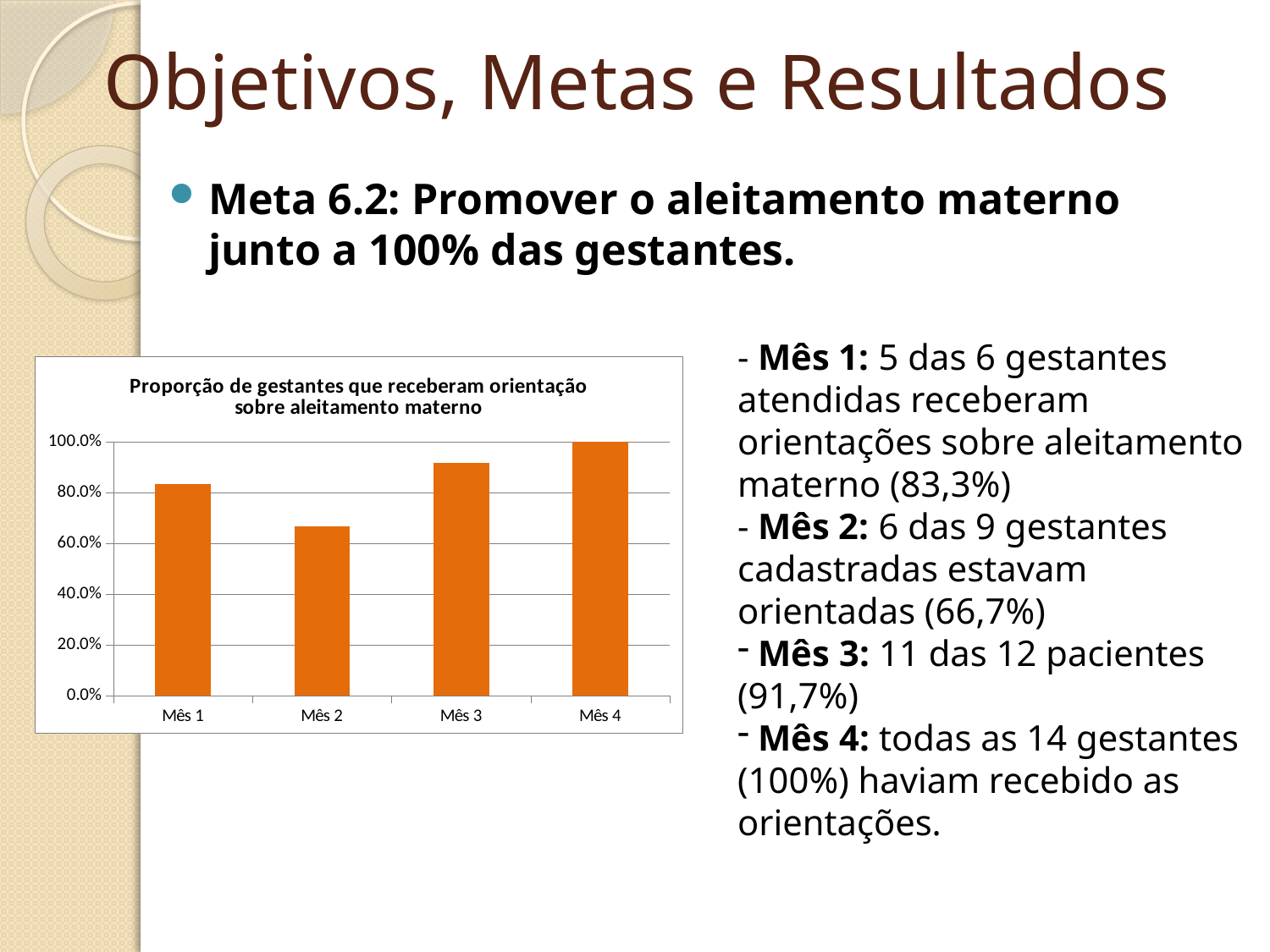
Is the value for Mês 3 greater or less than 80.0%? greater Which is larger, the value for Mês 1 or the value for Mês 2? Mês 1 Is the value for Mês 2 greater or less than 80.0%? less Which is larger, the value for Mês 3 or the value for Mês 1? Mês 3 What is the title of the chart? Proporção de gestantes que receberam orientação sobre aleitamento materno Which month has the highest proportion on the chart? Mês 4 Is the value for Mês 1 greater or less than 80.0%? greater From Mês 2 to Mês 4, do the values rise or fall? rise What value does the bar for Mês 4 reach on the axis? 100.0% What kind of chart is shown on the slide? bar chart Which month has the lowest proportion on the chart? Mês 2 How many categories (months) are plotted on the chart? 4